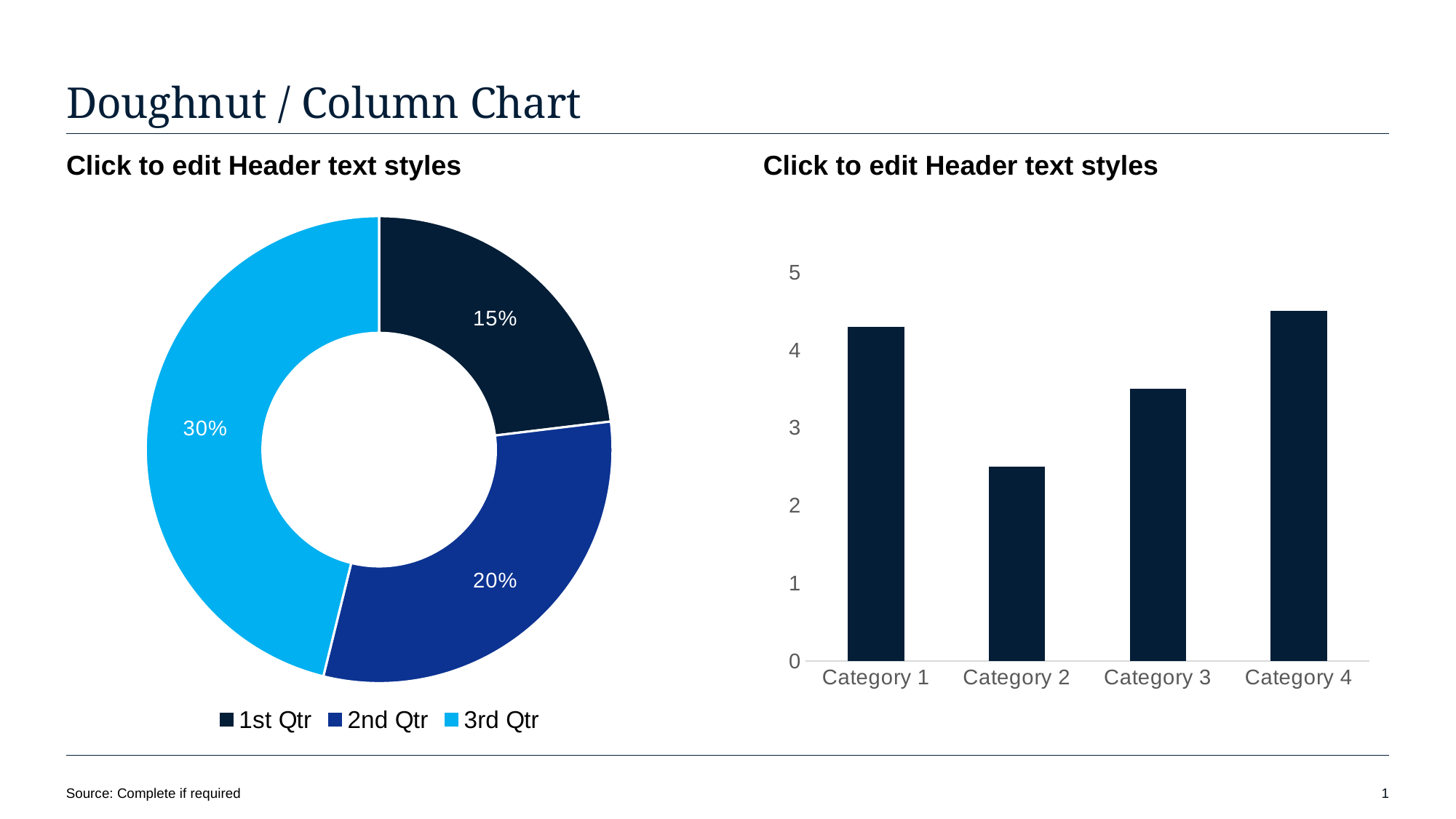
On the doughnut chart on the left, which quarter has the smallest share? 1st Qtr On the bar chart on the right, is the value for Category 2 greater or less than 3? less On the doughnut chart on the left, which quarter has the largest share? 3rd Qtr On the doughnut chart on the left, what percentage is shown for 2nd Qtr? 20% On the doughnut chart on the left, how many entries does the legend list? 3 On the bar chart on the right, is the value for Category 4 greater or less than 4? greater On the doughnut chart on the left, what percentage is shown for 1st Qtr? 15% What kind of chart is shown on the left of the slide? Doughnut chart On the doughnut chart on the left, what percentage is shown for 3rd Qtr? 30% On the doughnut chart on the left, how many percentage points larger is 3rd Qtr than 1st Qtr? 15% On the bar chart on the right, how many categories are shown on the x axis? 4 On the bar chart on the right, which category has the lowest value? Category 2